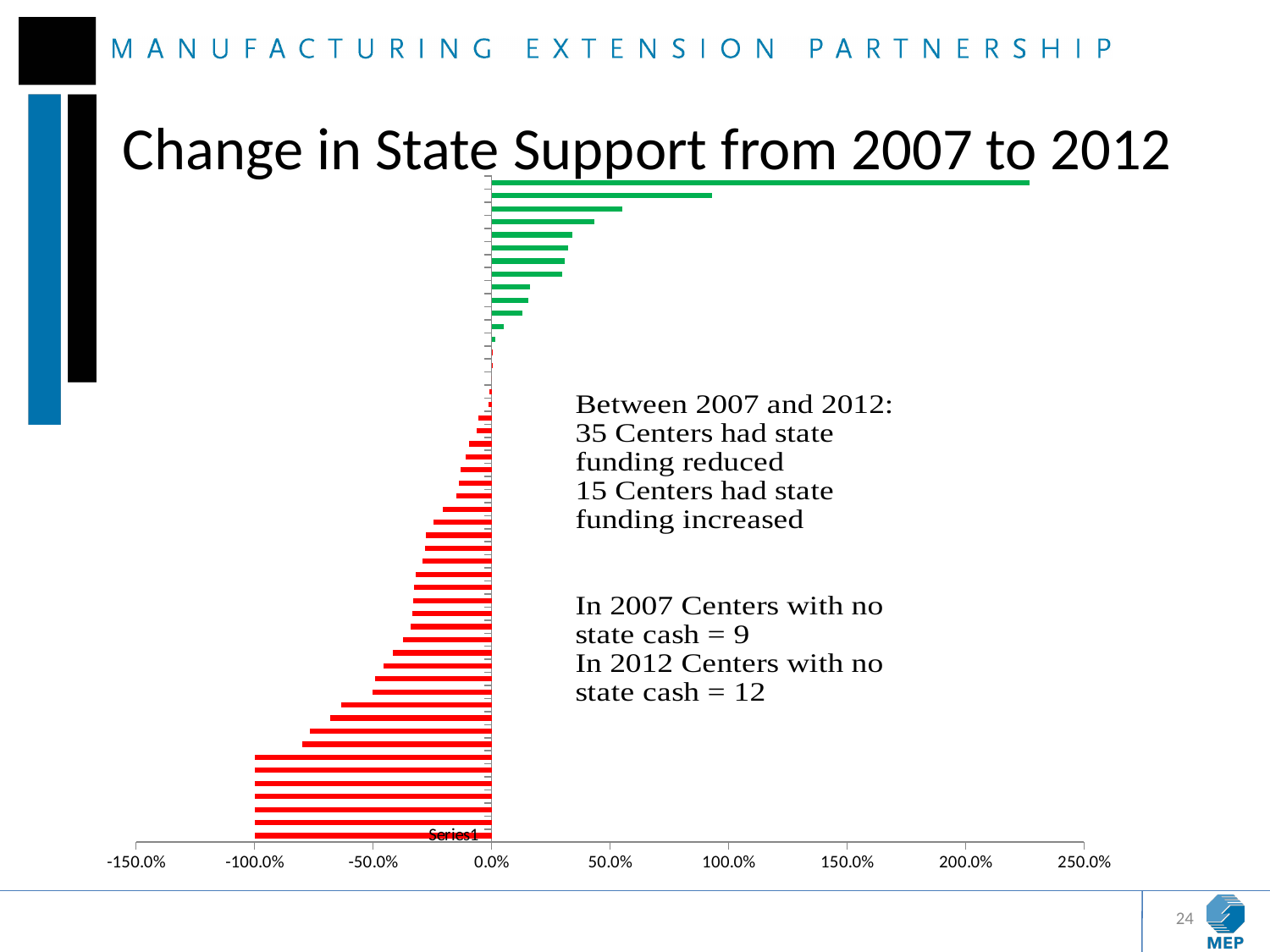
How many series does the chart legend list? 1 What is the title of the chart on the slide? Change in State Support from 2007 to 2012 Which colour are the bars with negative values? red What kind of chart is shown on the slide? bar chart Do the bar values increase or decrease going from the top of the chart to the bottom? decrease Is the longest green bar or the longest red bar larger in absolute length? the longest green bar Is the value of the second-longest green bar greater or less than 100.0%? less Is the value of the longest green bar at the top of the chart greater or less than 200.0%? greater What is the name of the series shown in the chart legend? Series1 Is the value of the longest red bar at the bottom of the chart greater or less than -50.0%? less